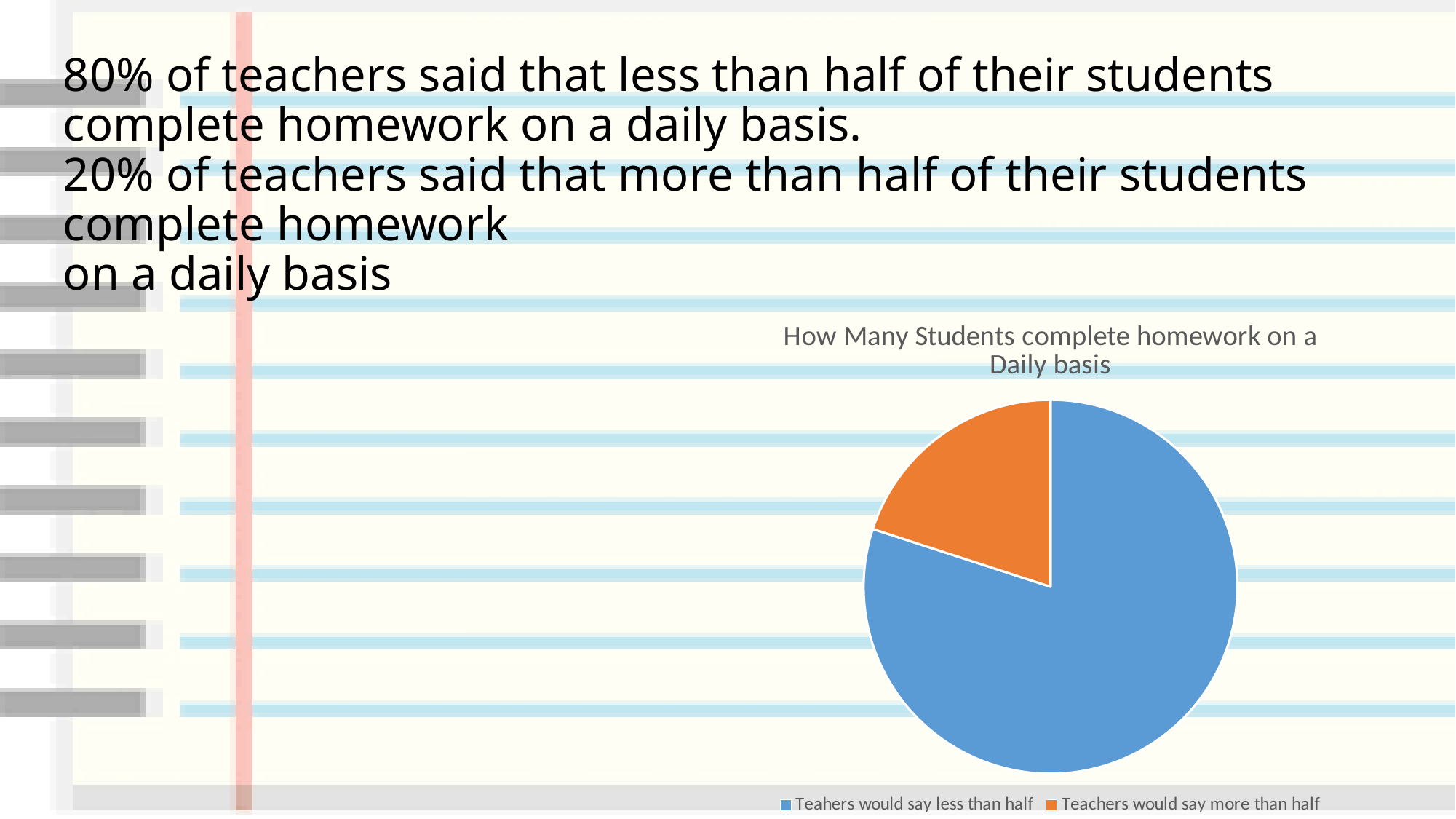
Which slice of the pie chart is the largest? Teahers would say less than half How many entries does the legend of the pie chart list? 2 Which is larger in the pie chart: the slice for teachers who would say less than half or the slice for teachers who would say more than half? Teahers would say less than half What colour is the slice for teachers who would say more than half? orange What is the title of the pie chart? How Many Students complete homework on a Daily basis Which slice of the pie chart is the smallest? Teachers would say more than half How many slices does the pie chart have? 2 What kind of chart is shown on the slide? pie chart What share of the pie does the slice for teachers who would say more than half represent? 20% What share of the pie does the slice for teachers who would say less than half represent? 80%